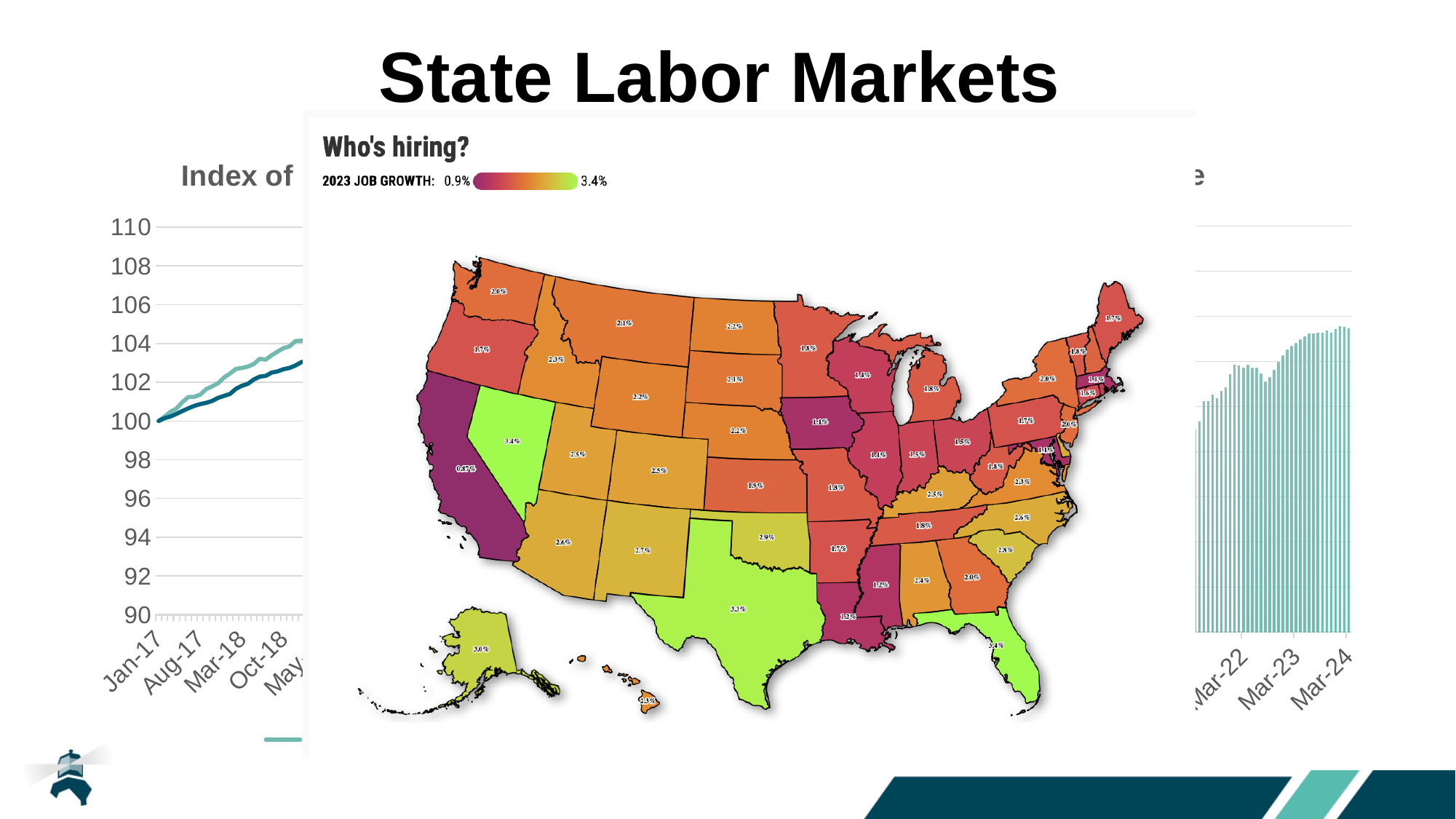
What is the title of the map in the centre of the slide? Who's hiring? On the 'Who's hiring?' map, what 2023 job growth value is printed on Texas? 3.3% On the 'Who's hiring?' map, what is the highest 2023 job growth value shown on the colour scale? 3.4% On the left line chart, what is the highest value shown on the y axis? 110 On the 'Who's hiring?' map, what is the lowest 2023 job growth value shown on the colour scale? 0.9% On the left line chart, is the value of the upper (lighter) line at Oct-18 greater or less than 102? greater On the 'Who's hiring?' map, which has the higher 2023 job growth, California or Texas? Texas On the right bar chart, do the bars generally rise or fall from Mar-22 to Mar-24? rise What kind of chart is the chart on the right side of the slide (with the Mar-22 to Mar-24 axis)? bar chart On the left line chart, do the values rise or fall from Jan-17 to Oct-18? rise On the left line chart, what value do the lines start at in Jan-17? 100 What kind of chart is the chart on the left side of the slide (with the Jan-17 to Oct-18 axis)? line chart